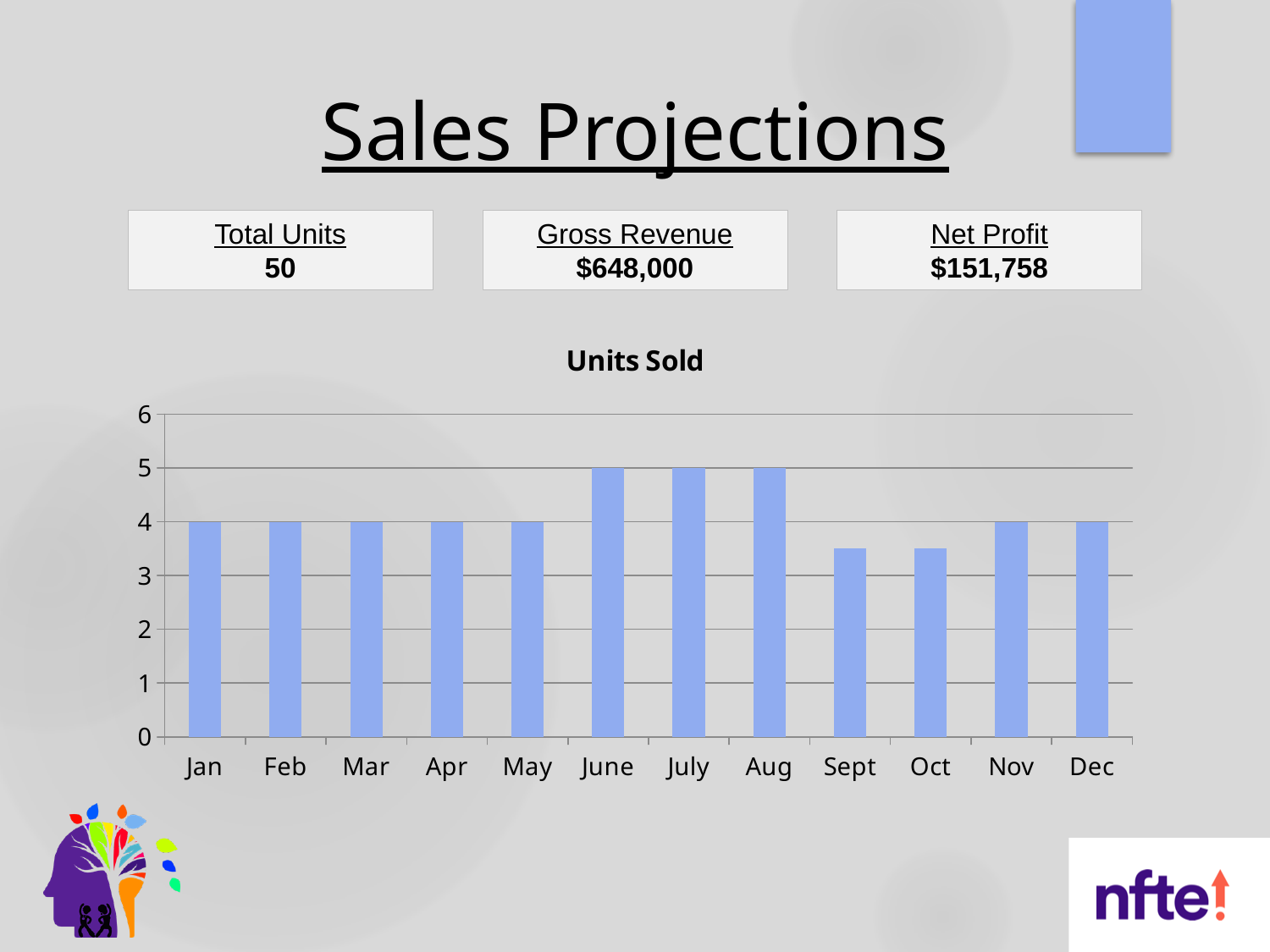
What is the difference between the value for Aug and the value for Feb in the Units Sold chart? 1 Is the value for Oct in the Units Sold chart greater or less than 3? greater What is the value for Jan in the Units Sold chart? 4 How many months are shown on the x axis of the Units Sold chart? 12 Which is larger in the Units Sold chart, the value for July or the value for Mar? July What is the value for Dec in the Units Sold chart? 4 What type of chart is shown on the slide? bar chart What is the title of the chart? Units Sold Is the value for Sept in the Units Sold chart greater or less than 4? less Which is larger in the Units Sold chart, the value for Apr or the value for Sept? Apr What is the highest value shown on the y axis of the Units Sold chart? 6 What is the value for June in the Units Sold chart? 5